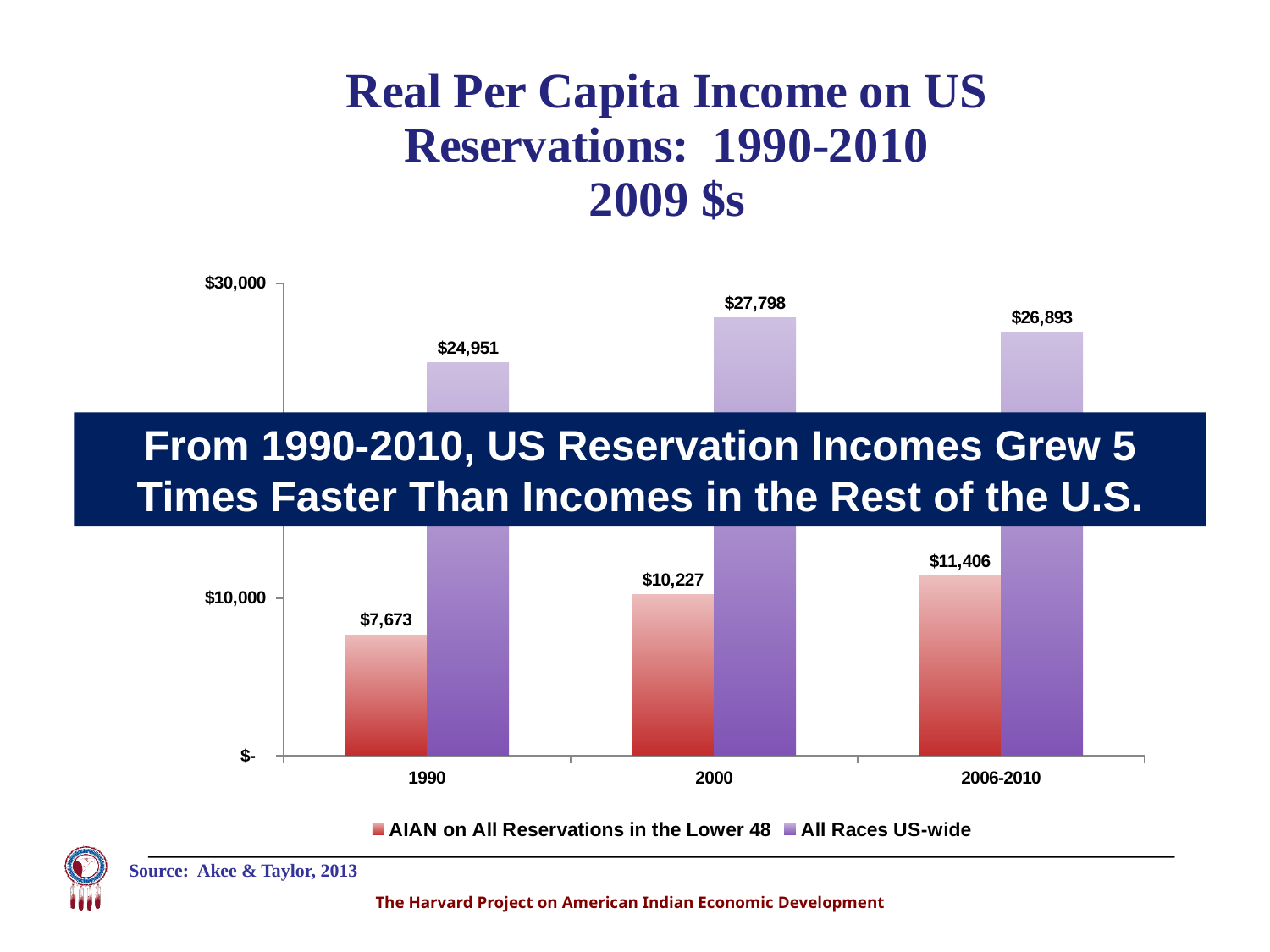
What is the value for AIAN on All Reservations in the Lower 48 in 1990? $7,673 What kind of chart is shown on the slide? Bar chart How many periods are shown on the x axis? 3 Do the AIAN on All Reservations in the Lower 48 values rise or fall from 1990 to 2006-2010? Rise Which is larger: All Races US-wide in 1990 or All Races US-wide in 2006-2010? All Races US-wide in 2006-2010 In which period is the All Races US-wide value highest? 2000 How much did the AIAN on All Reservations in the Lower 48 value increase from 1990 to 2006-2010? $3,733 How many series does the legend list? 2 What is the difference between All Races US-wide and AIAN on All Reservations in the Lower 48 in 2000? $17,571 In which period is the AIAN on All Reservations in the Lower 48 value lowest? 1990 What is the value for All Races US-wide in 2000? $27,798 What is the value for AIAN on All Reservations in the Lower 48 in 2006-2010? $11,406